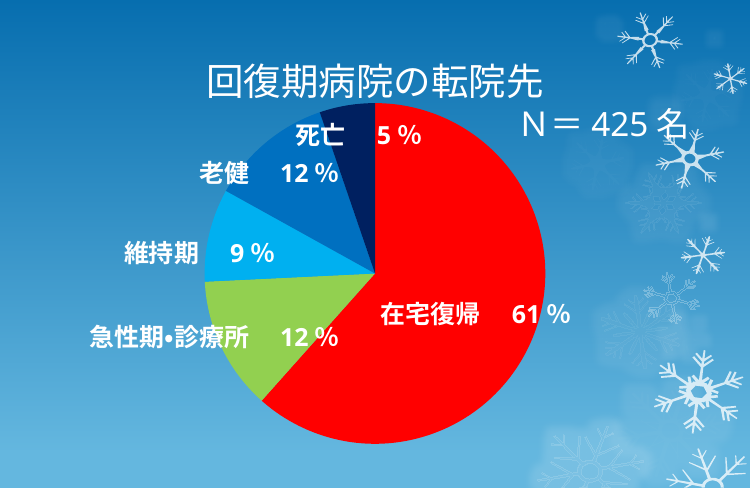
What kind of chart is shown on the slide? pie chart Which category has the largest share of the pie? 在宅復帰 What is the percentage for 死亡? 5% Which category has the smallest share of the pie? 死亡 What is the percentage for 維持期? 9% How many slices does the pie chart have? 5 What is the sample size (N) shown on the slide? 425名 What is the percentage for 老健? 12% What is the percentage for 在宅復帰? 61% What is the title of the chart? 回復期病院の転院先 Which is larger, the share for 維持期 or the share for 老健? 老健 What is the difference in percentage points between 在宅復帰 and 急性期・診療所? 49